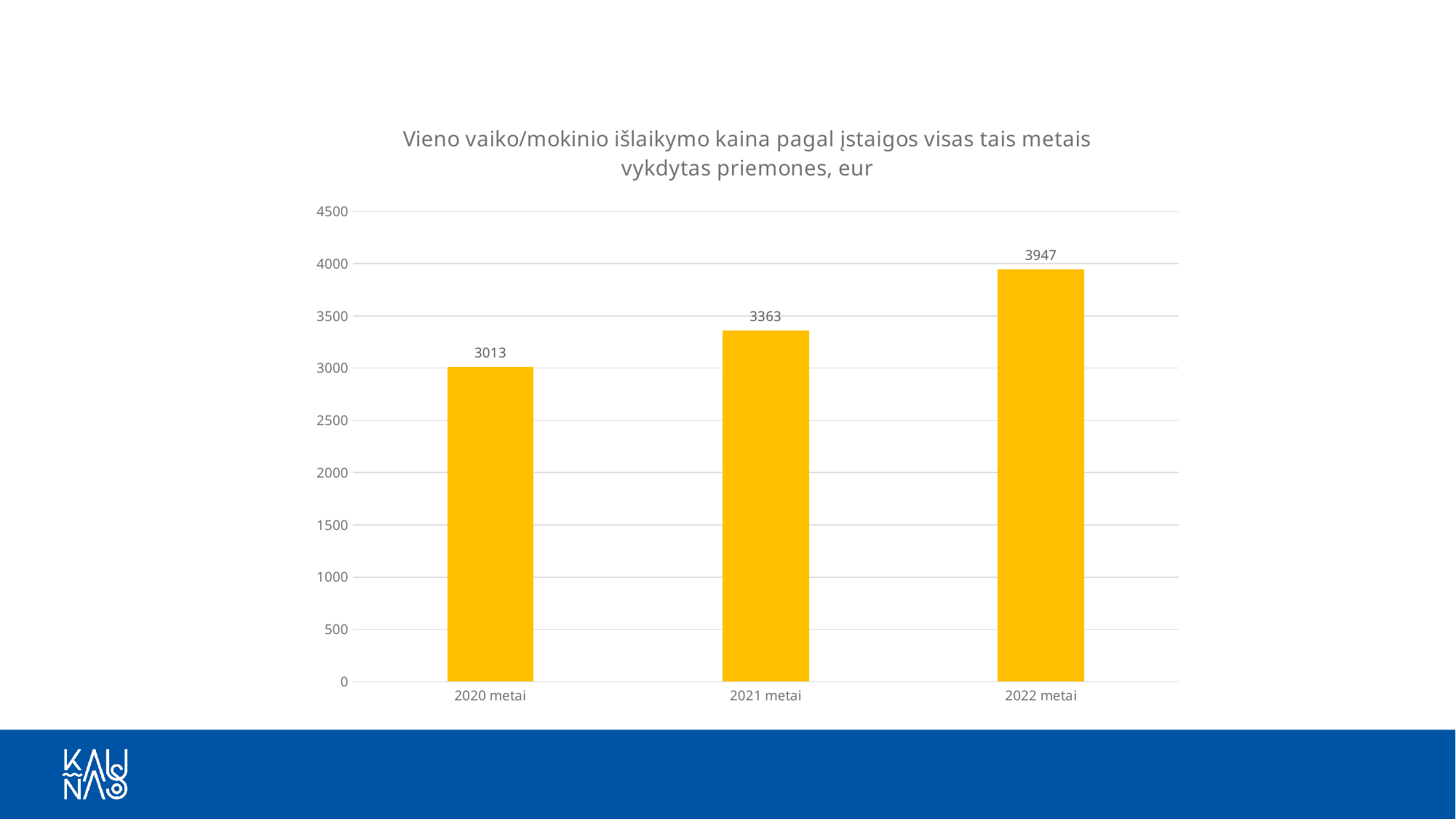
What is the difference between the values for 2021 metai and 2020 metai? 350 Which year has the lowest value? 2020 metai What is the value for 2022 metai? 3947 What is the value for 2021 metai? 3363 Which year has the highest value? 2022 metai How many bars are shown in the chart? 3 Do the values rise or fall from 2020 metai to 2022 metai? rise Is the value for 2022 metai greater or less than 3500? greater What is the value for 2020 metai? 3013 What kind of chart is shown on the slide? bar chart Which is larger, the value for 2021 metai or the value for 2022 metai? 2022 metai What is the difference between the values for 2022 metai and 2020 metai? 934